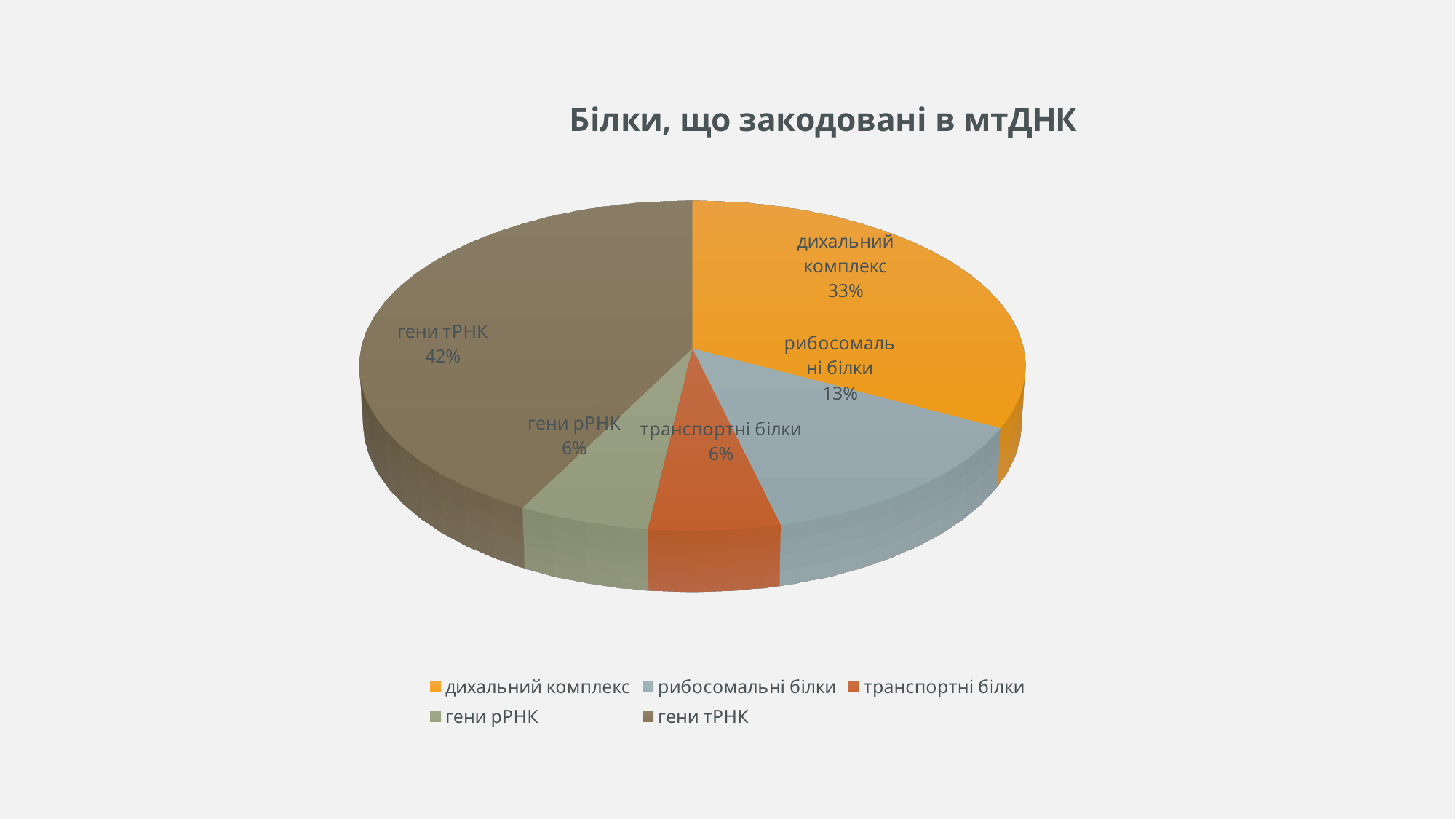
What colour is the slice for транспортні білки? orange-red What share of the pie is labelled for транспортні білки? 6% Which is larger, the slice for дихальний комплекс or the slice for рибосомальні білки? дихальний комплекс What kind of chart is shown on the slide? pie chart Which category has the largest slice of the pie? гени тРНК What is the title of the chart? Білки, що закодовані в мтДНК How many entries does the legend list? 5 What is the difference in percentage points between гени тРНК and дихальний комплекс? 9 What share of the pie is labelled for гени тРНК? 42% How many slices does the pie chart have? 5 What share of the pie is labelled for дихальний комплекс? 33% What share of the pie is labelled for рибосомальні білки? 13%